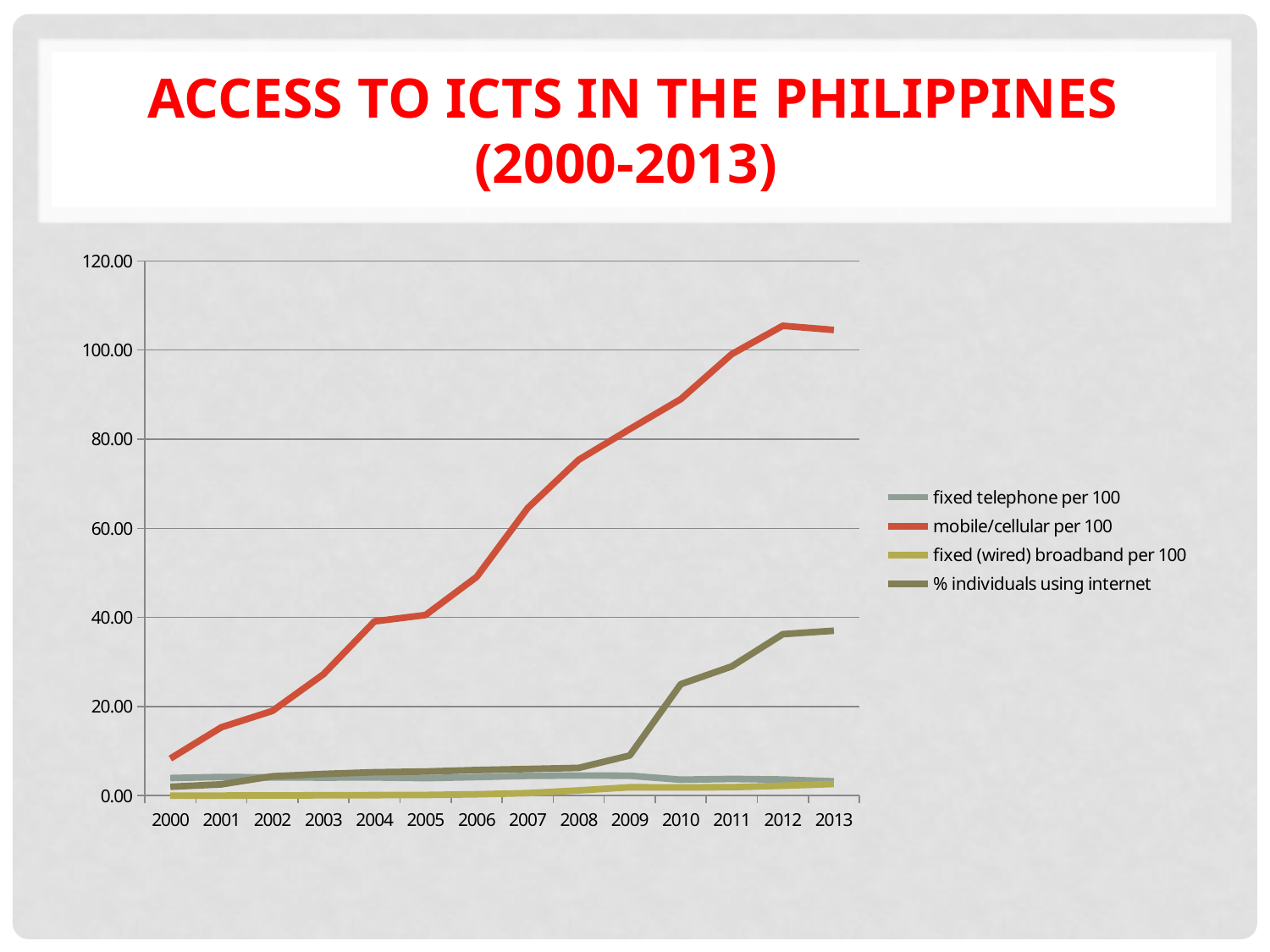
How many series does the legend list? 4 How many years are plotted along the x axis? 14 Does the mobile/cellular per 100 line rise or fall from 2000 to 2013? rise What kind of chart is shown on the slide? line chart Is the value for mobile/cellular per 100 in 2012 greater or less than 100.00? greater Which series has the highest value in 2013? mobile/cellular per 100 Is the value for mobile/cellular per 100 in 2000 greater or less than 20.00? less Is the value for mobile/cellular per 100 in 2008 greater or less than 60.00? greater In 2013, which is larger: mobile/cellular per 100 or fixed telephone per 100? mobile/cellular per 100 Which series has the lowest value in 2005? fixed (wired) broadband per 100 What is the title of the slide? ACCESS TO ICTS IN THE PHILIPPINES (2000-2013)